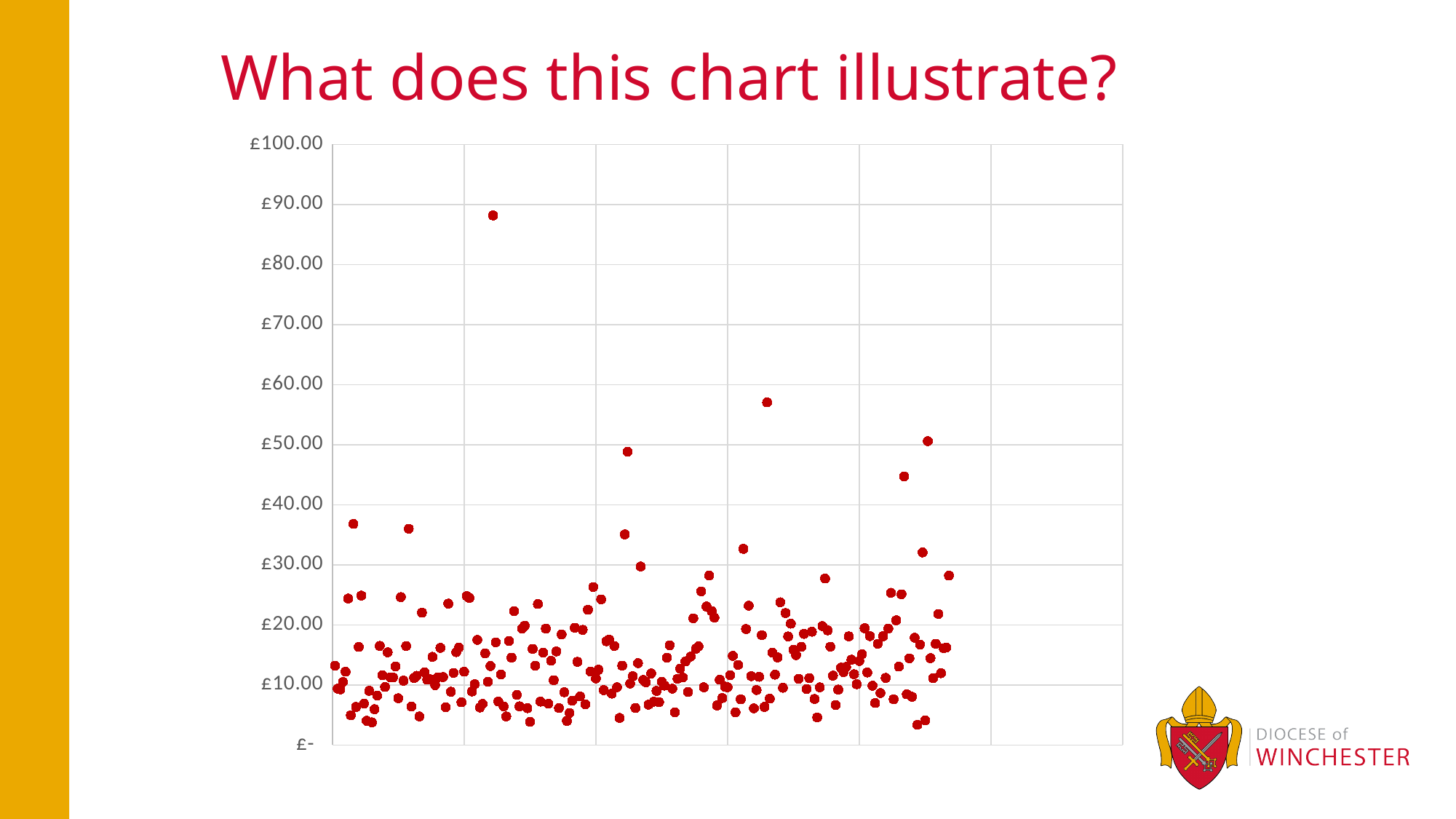
Is the highest point on the chart greater or less than £80.00? greater How many points on the chart lie above £40.00? 5 What kind of chart is shown on the slide? scatter chart How many points on the chart lie above £60.00? 1 What is the title of the slide containing the chart? What does this chart illustrate? What is the highest value labelled on the vertical axis? £100.00 Is the second-highest point on the chart greater or less than £50.00? greater Are the majority of the points on the chart above or below £30.00? below